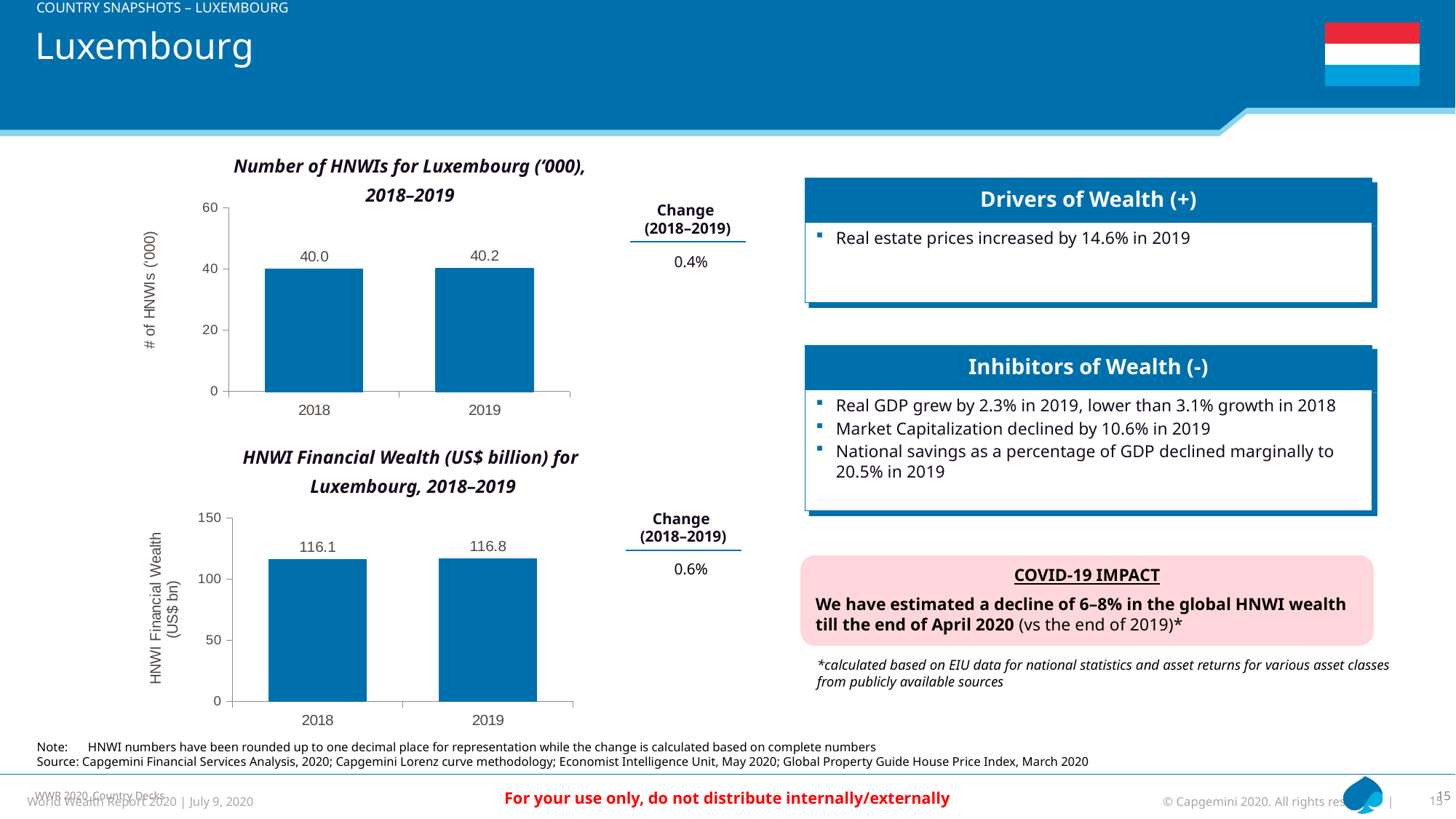
In the 'HNWI Financial Wealth' chart, what is the value for 2019? 116.8 In the 'Number of HNWIs for Luxembourg' chart, do the values rise or fall from 2018 to 2019? rise In the 'Number of HNWIs for Luxembourg' chart, what is the value for 2019? 40.2 In the 'HNWI Financial Wealth' chart, what is the value for 2018? 116.1 In the 'Number of HNWIs for Luxembourg' chart, what is the value for 2018? 40.0 What is the y-axis label of the 'Number of HNWIs for Luxembourg' chart? # of HNWIs ('000) How many categories are shown on the x axis of the 'Number of HNWIs for Luxembourg' chart? 2 What is the percentage change (2018–2019) shown next to the 'HNWI Financial Wealth' chart? 0.6% In the 'HNWI Financial Wealth' chart, is the value for 2019 greater or less than 100? greater In the 'HNWI Financial Wealth' chart, what is the difference between the 2019 and 2018 values? 0.7 What type of chart is the 'HNWI Financial Wealth' chart? Bar chart In the 'Number of HNWIs for Luxembourg' chart, what is the difference between the 2019 and 2018 values? 0.2